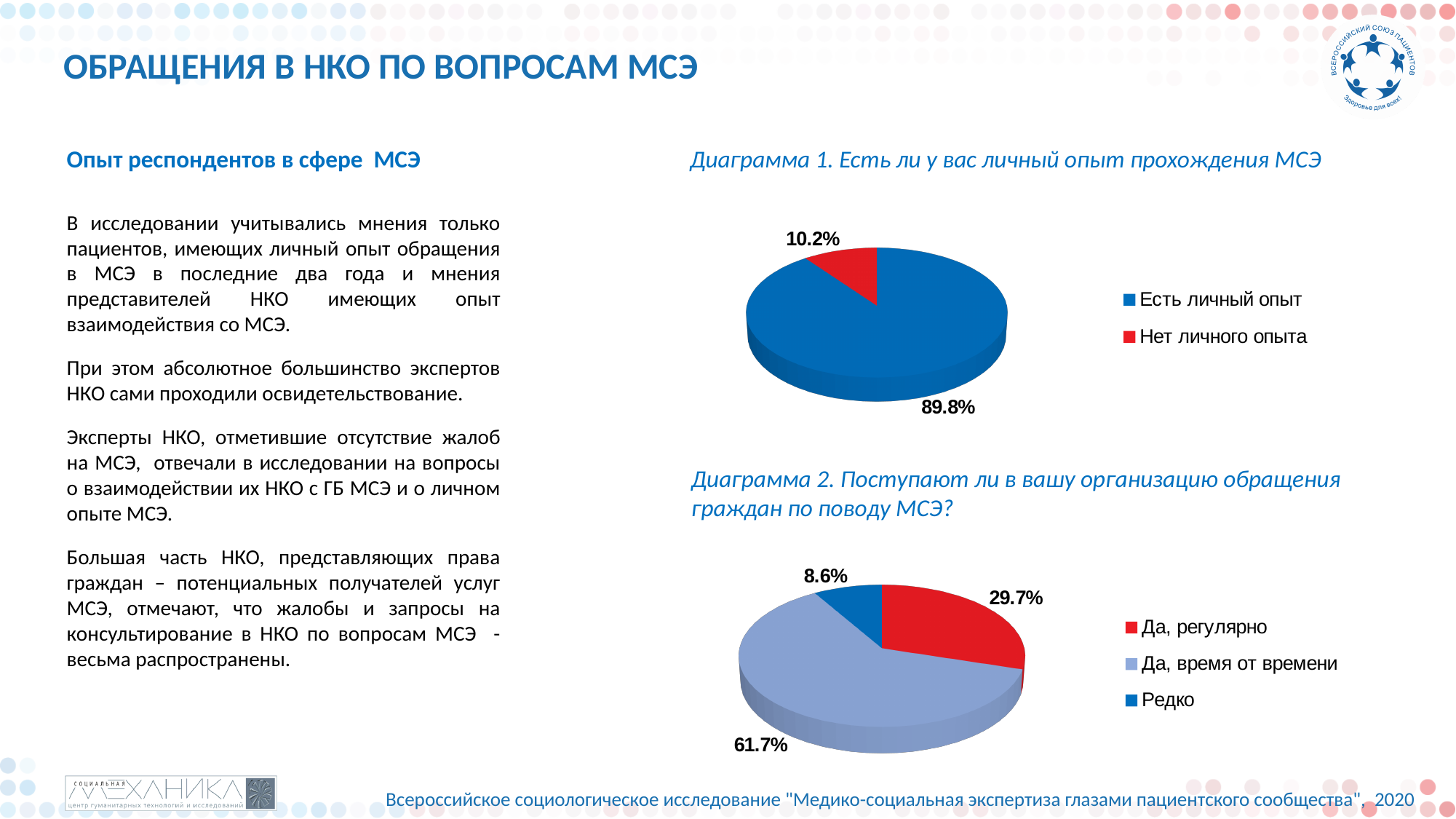
In Диаграмма 2, what colour is the "Да, время от времени" slice? Light blue In Диаграмма 1, what share of respondents answered "Нет личного опыта"? 10.2% In Диаграмма 2, what share of respondents answered "Редко"? 8.6% What type of chart is Диаграмма 1? Pie chart In Диаграмма 1, what share of respondents answered "Есть личный опыт"? 89.8% In Диаграмма 2, what share of respondents answered "Да, регулярно"? 29.7% In Диаграмма 2, what share of respondents answered "Да, время от времени"? 61.7% In Диаграмма 1, what is the difference in percentage points between "Есть личный опыт" and "Нет личного опыта"? 79.6 In Диаграмма 2, which is larger: "Да, регулярно" or "Редко"? Да, регулярно How many categories does the legend of Диаграмма 2 list? 3 In Диаграмма 2, which category has the smallest share? Редко In Диаграмма 1, which category has the largest share? Есть личный опыт